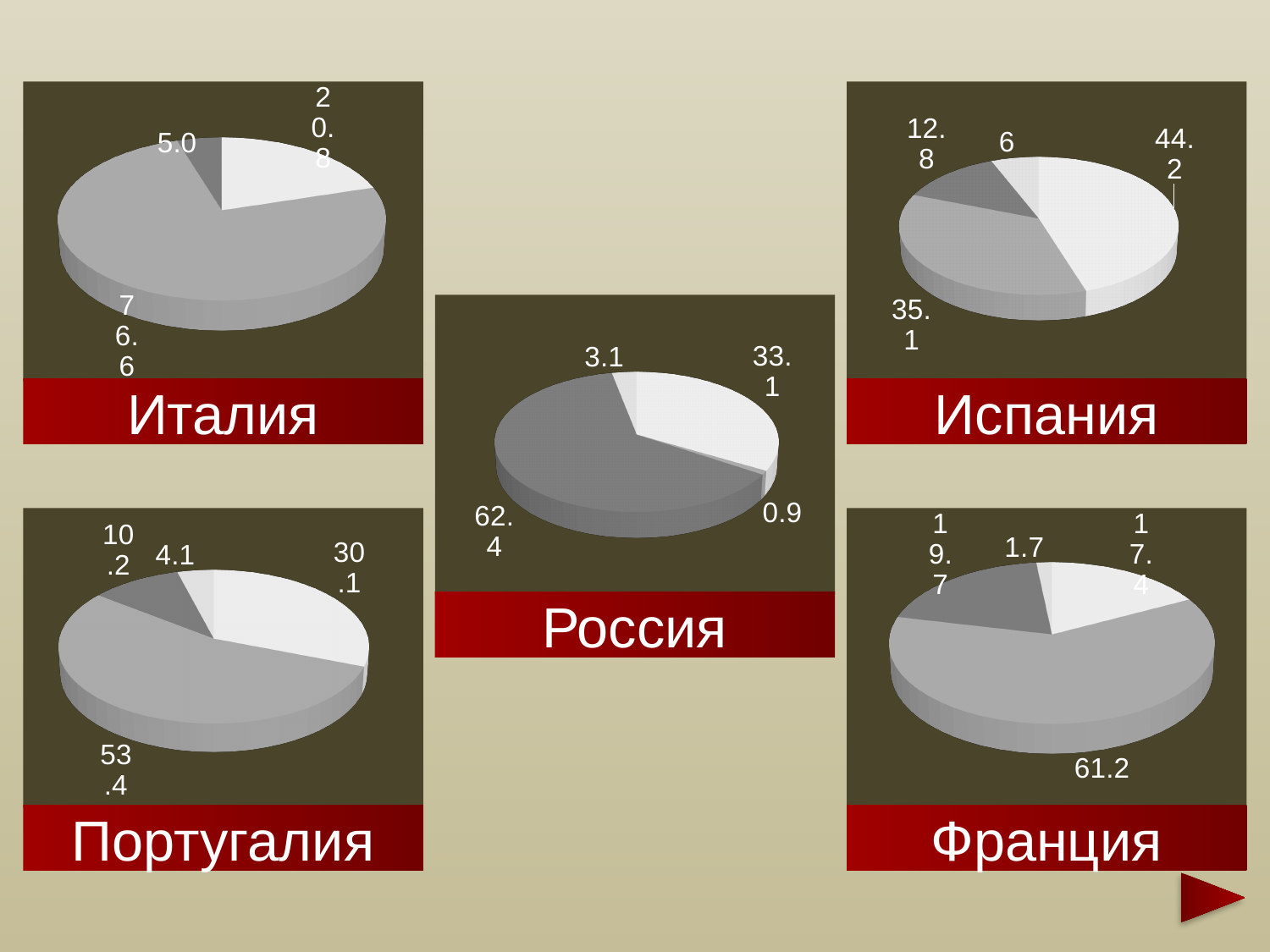
How many slices does the Россия pie chart have? 4 What type of charts are shown on the slide? Pie charts In the Россия chart, what is the value of the smallest slice? 0.9 In the Франция chart, what is the value of the largest slice? 61.2 In the Франция chart, what is the value of the smallest slice? 1.7 How many pie charts are on the slide? 5 In the Италия chart, what is the value of the smallest slice? 5.0 In the Россия chart, what is the value of the largest slice? 62.4 In the Испания chart, what is the value of the largest slice? 44.2 Which is larger: the largest slice in the Россия chart (62.4) or the largest slice in the Франция chart (61.2)? Россия (62.4)